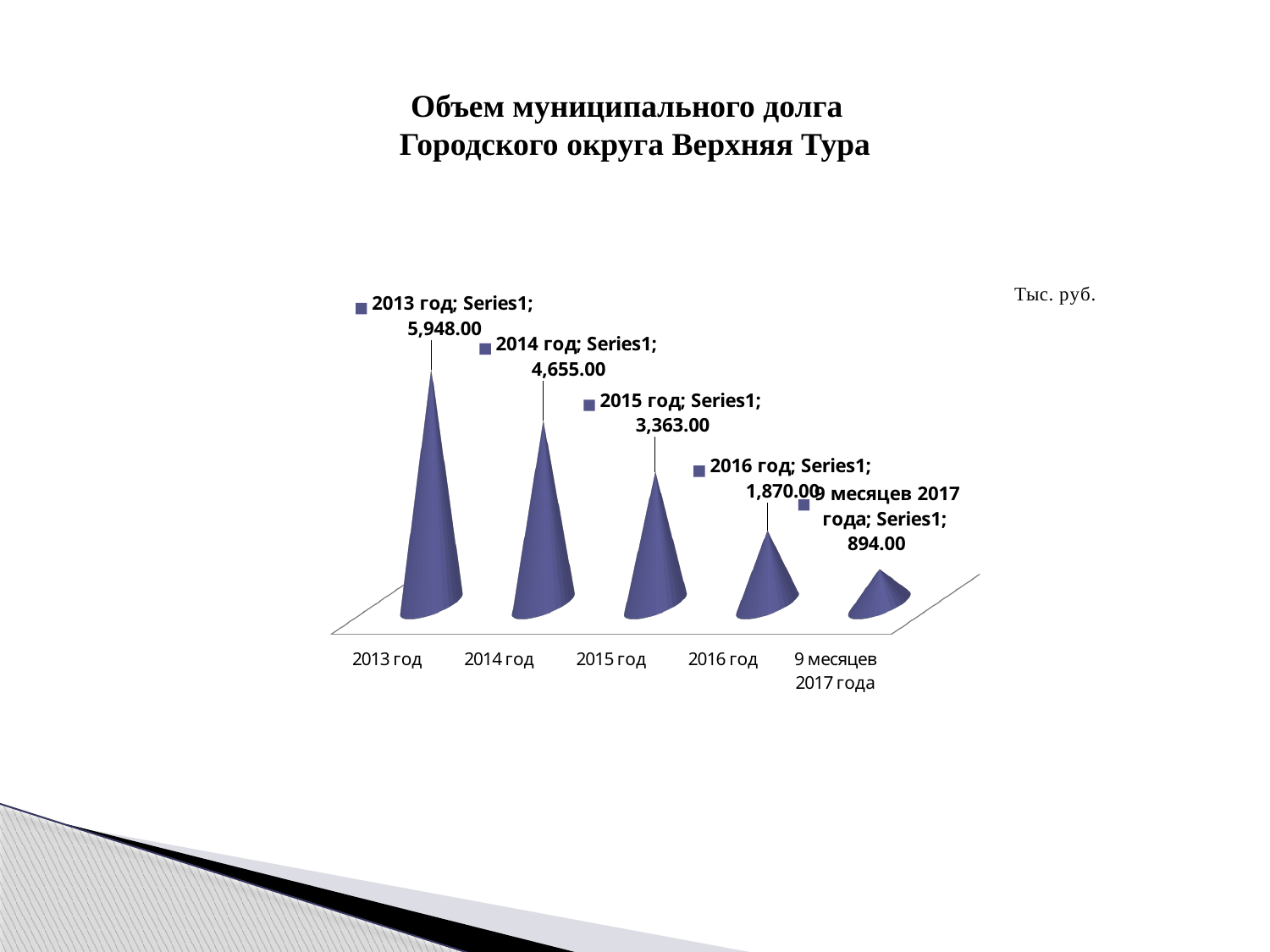
What is the value for 2013 год? 5,948.00 Which is larger, the value for 2014 год or the value for 2015 год? 2014 год How many categories are shown on the x axis? 5 What unit is indicated for the chart values? Тыс. руб. What is the difference between the values for 2013 год and 2014 год? 1,293.00 What is the value for 9 месяцев 2017 года? 894.00 Which category has the lowest value? 9 месяцев 2017 года Do the values rise or fall from 2013 год to 9 месяцев 2017 года? fall What kind of chart is shown on the slide? bar chart Which category has the highest value? 2013 год What is the value for 2015 год? 3,363.00 What is the difference between the values for 2016 год and 9 месяцев 2017 года? 976.00